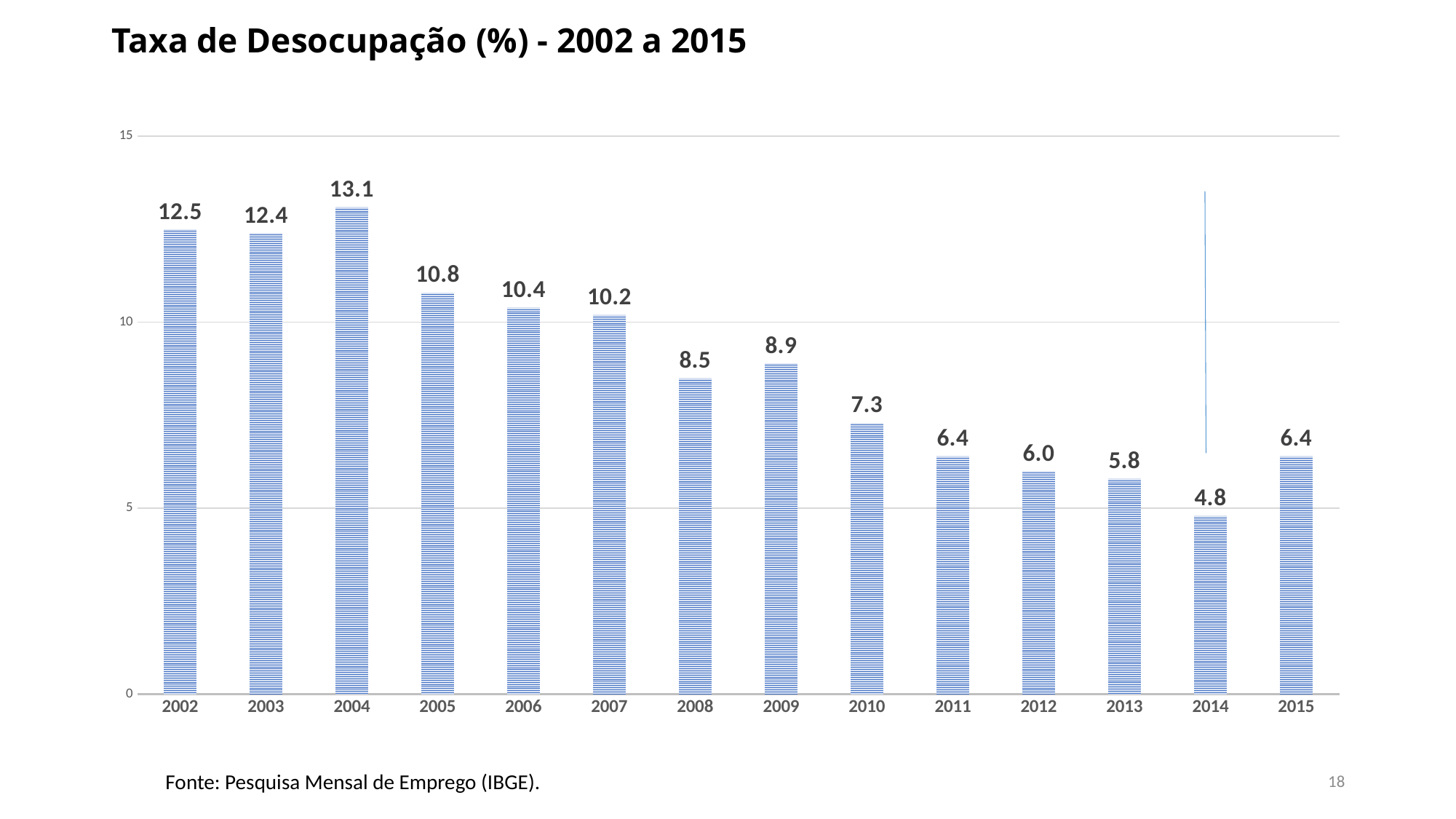
What kind of chart is shown on the slide? bar chart What is the difference between the values for 2002 and 2015? 6.1 What is the value for 2009? 8.9 Which year has the highest value? 2004 What is the value for 2014? 4.8 How many years are shown on the x axis? 14 Which year has the lowest value? 2014 Is the value for 2010 greater or less than 10? less Do the values generally rise or fall from 2002 to 2014? fall What is the title of the chart? Taxa de Desocupação (%) - 2002 a 2015 What is the value for 2004? 13.1 Which is larger, the value for 2008 or the value for 2009? 2009